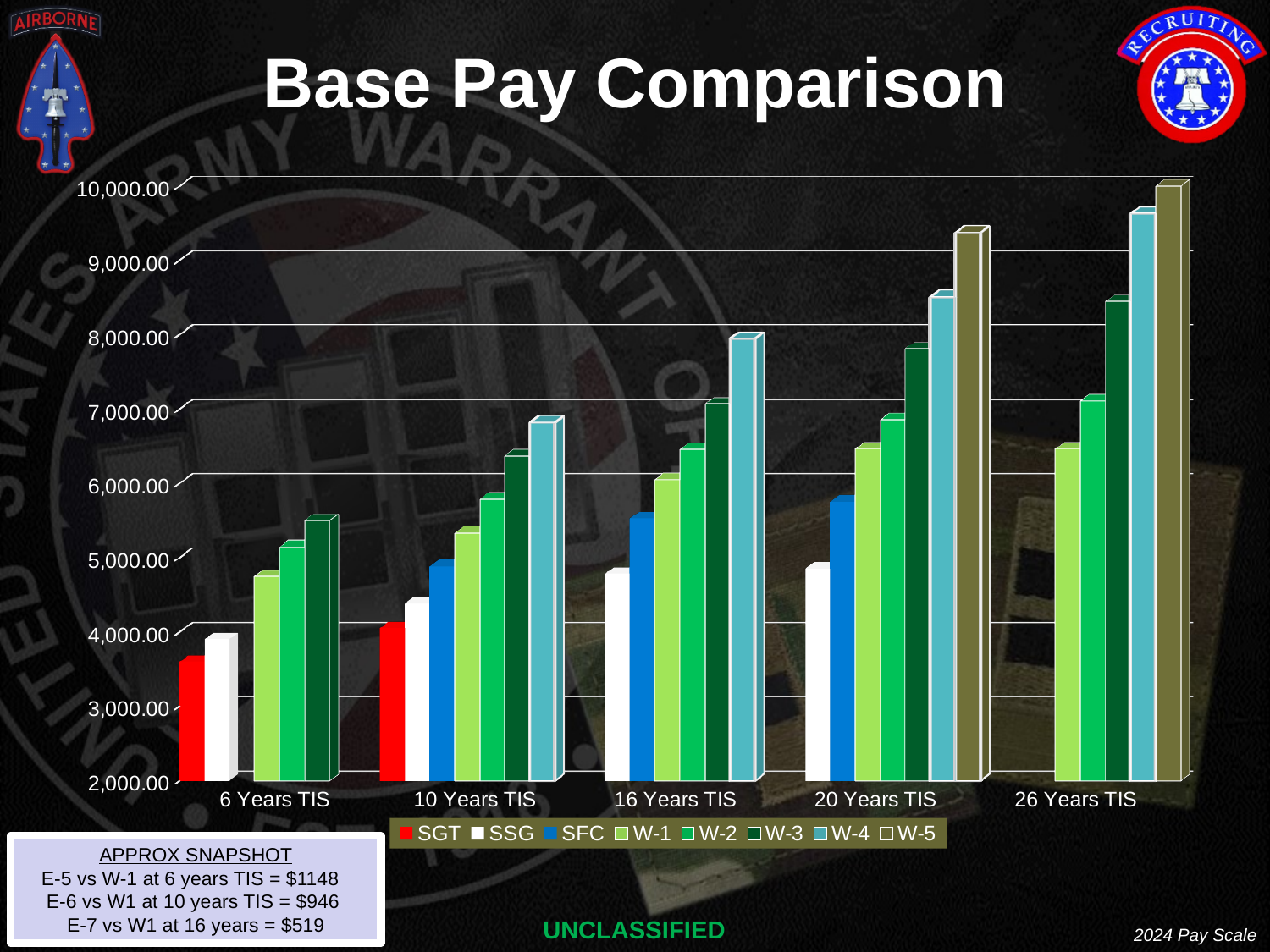
What is the title of the chart? Base Pay Comparison At 20 Years TIS, which is larger, W-4 or W-3? W-4 Which series has the lowest bar at 6 Years TIS? SGT Is the value for SFC at 20 Years TIS greater or less than 6,000.00? less Is the value for W-3 at 10 Years TIS greater or less than 6,000.00? greater How many series does the legend list? 8 Is the value for SGT at 6 Years TIS greater or less than 4,000.00? less How many TIS categories are shown on the x axis? 5 What kind of chart is shown on the slide? bar chart Which series has the highest bar in the whole chart? W-5 Do the W-1 values rise or fall as years of TIS increase along the x axis? rise